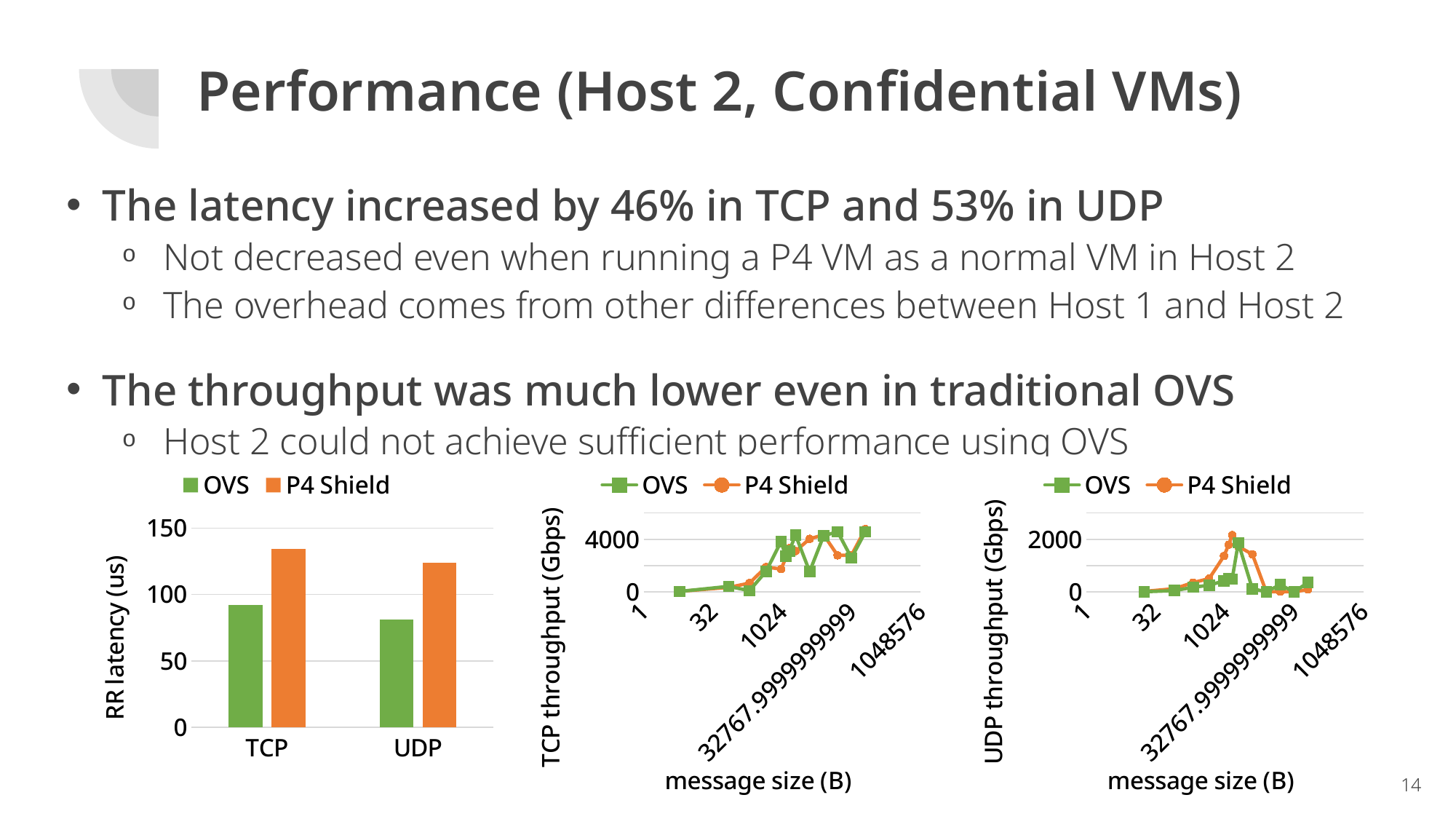
In the RR latency chart, which bar is the lowest? OVS for UDP In the RR latency chart, which is larger for UDP: OVS or P4 Shield? P4 Shield In the RR latency chart, is the P4 Shield value for TCP greater or less than 100? greater In the RR latency chart, which bar is the highest? P4 Shield for TCP In the RR latency chart, which colour represents P4 Shield? orange In the RR latency chart, is the OVS value for UDP greater or less than 100? less What kind of chart is the RR latency chart on the left? bar chart In the TCP throughput chart, what is the label of the x axis? message size (B) In the RR latency chart, how many categories are shown on the x axis? 2 What kind of chart is the TCP throughput chart in the middle? line chart In the UDP throughput chart, do the values rise steadily, fall steadily, or rise and then fall as message size increases? rise and then fall In the RR latency chart, how many series does the legend list? 2